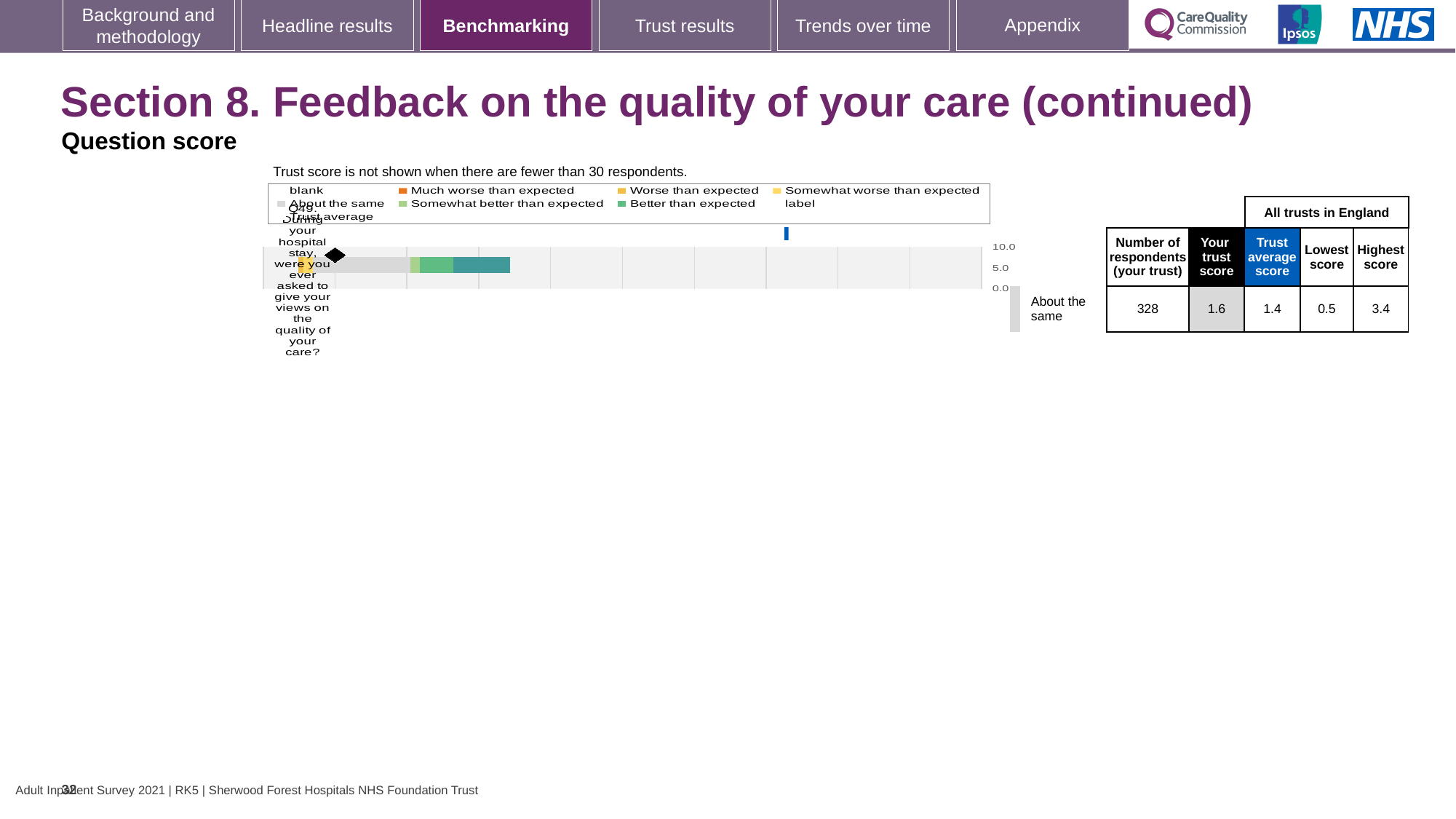
In the table beside the chart, how many respondents from your trust answered Q49? 328 For Q49, what is the difference between the highest score and the lowest score among all trusts in England? 2.9 For Q49, what is the difference between your trust score and the trust average score? 0.2 In the table beside the chart, what is the 'Highest score' among all trusts in England for Q49? 3.4 How many survey questions are plotted as categories in the chart? 1 Which question number is plotted in the chart? Q49 For Q49, which is larger: your trust score or the trust average score? Your trust score What benchmark category label is shown to the right of the chart for Q49? About the same What kind of chart is shown on the slide? bar chart In the table beside the chart, what is the 'Your trust score' for Q49? 1.6 In the table beside the chart, what is the 'Lowest score' among all trusts in England for Q49? 0.5 In the table beside the chart, what is the 'Trust average score' for Q49? 1.4